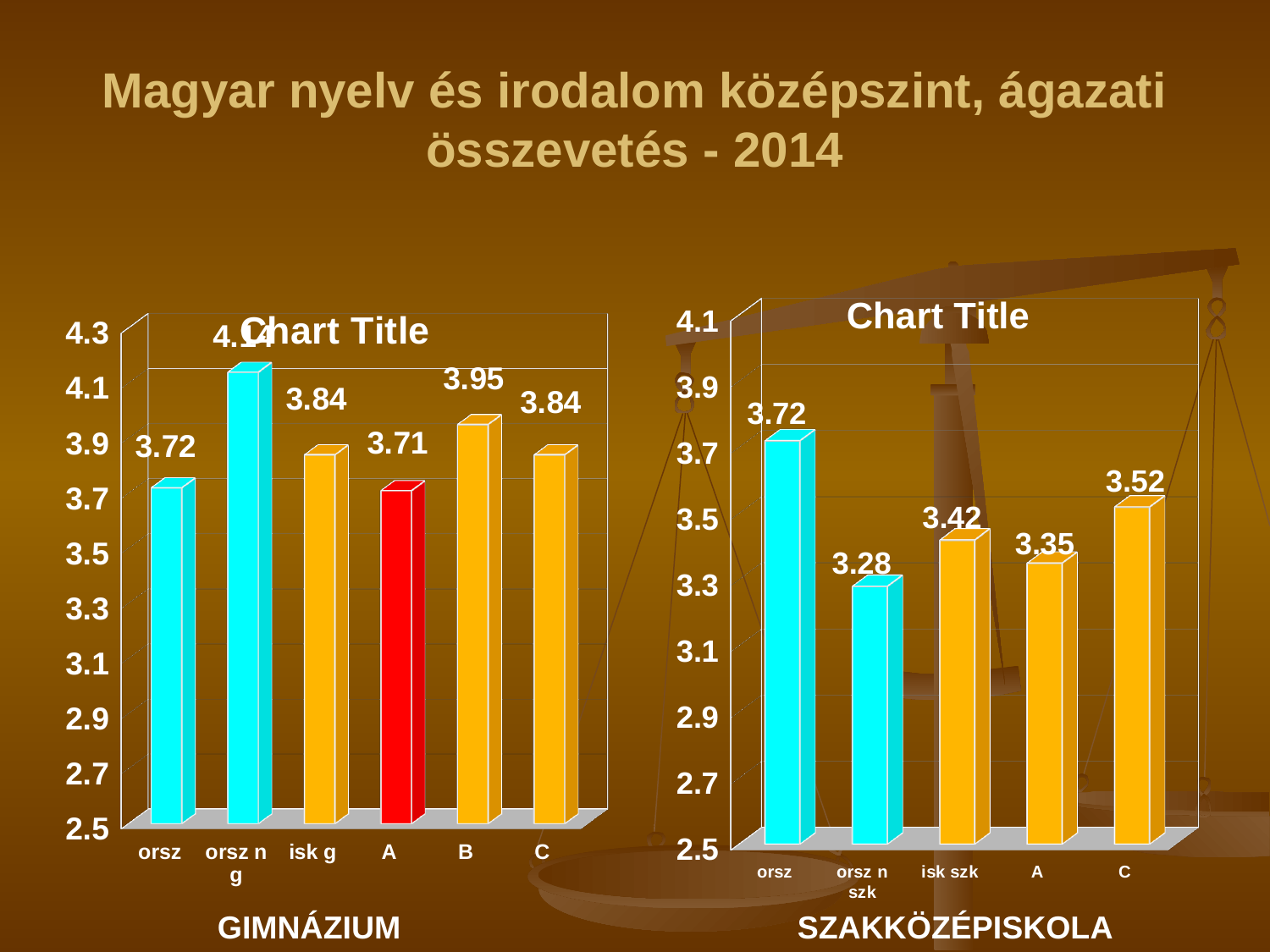
In the SZAKKÖZÉPISKOLA chart, what is the value for isk szk? 3.42 In the GIMNÁZIUM chart, what is the value for B? 3.95 In the SZAKKÖZÉPISKOLA chart, which category has the lowest value? orsz n szk In the GIMNÁZIUM chart, what is the value for A? 3.71 In the SZAKKÖZÉPISKOLA chart, what is the value for orsz n szk? 3.28 In the GIMNÁZIUM chart, which category has the lowest value? A In the SZAKKÖZÉPISKOLA chart, which is larger, the value for C or the value for A? C In the GIMNÁZIUM chart, what is the difference between the values for B and A? 0.24 In the SZAKKÖZÉPISKOLA chart, what is the difference between the values for orsz and C? 0.20 What kind of chart is the SZAKKÖZÉPISKOLA chart? bar chart In the GIMNÁZIUM chart, how many categories are shown on the x axis? 6 In the GIMNÁZIUM chart, which category has the highest value? orsz n g